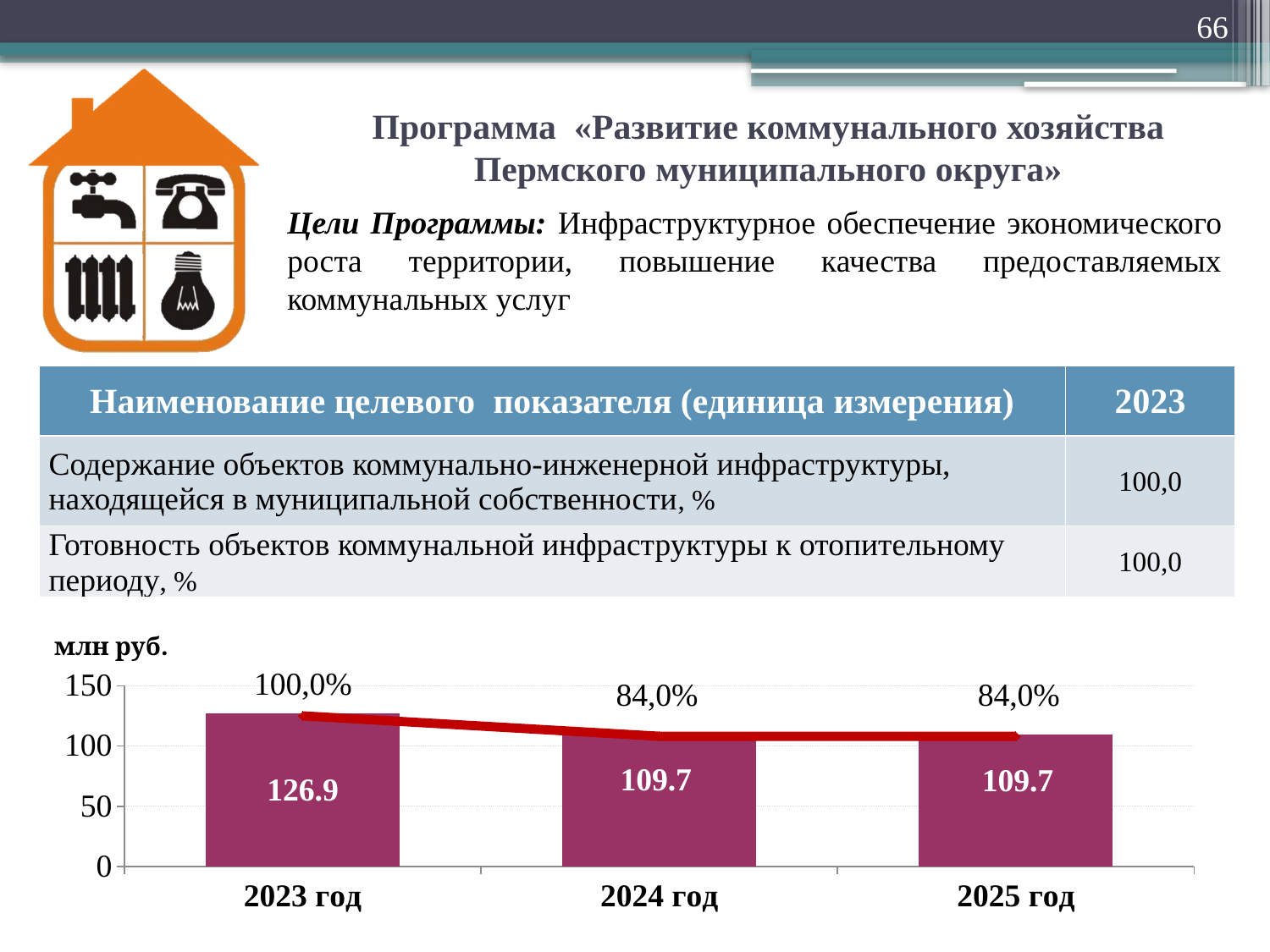
What is the value for 2025 год in the bar chart? 109.7 What kind of chart is shown at the bottom of the slide? combination bar and line chart What is the difference between the values for 2023 год and 2024 год? 17.2 Is the value for 2024 год greater or less than 150? less What is the value for 2024 год in the bar chart? 109.7 What unit is shown above the chart's y axis? млн руб. Which year has the highest bar in the chart? 2023 год Which is larger, the value for 2023 год or the value for 2025 год? 2023 год What percentage label is shown above the 2024 год bar? 84,0% Do the bar values rise or fall from 2023 год to 2025 год? fall What is the value for 2023 год in the bar chart? 126.9 How many years are shown on the x axis of the chart? 3